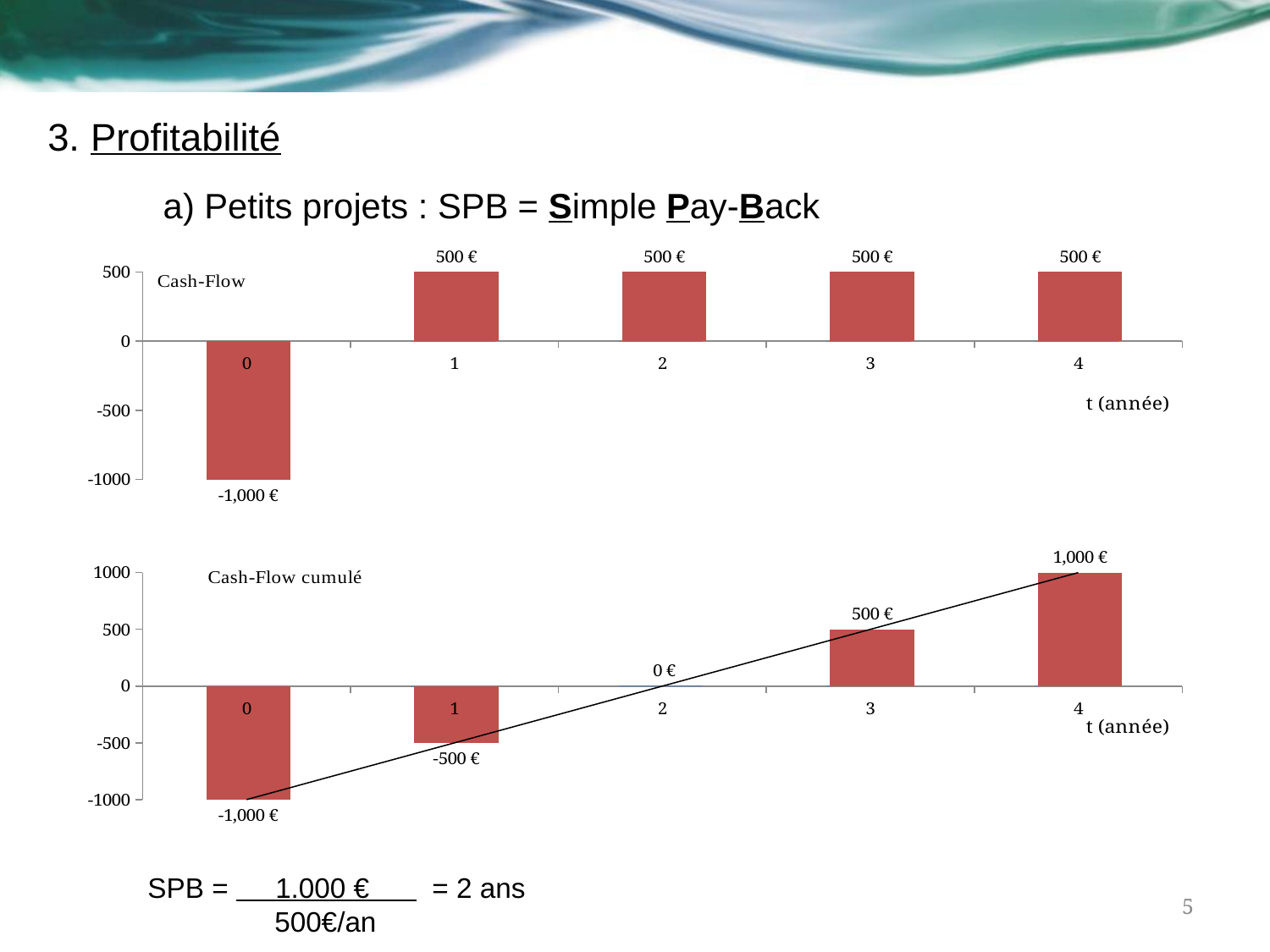
In the Cash-Flow cumulé chart, do the values rise or fall from year 0 to year 4? rise How many years (categories) are plotted in the Cash-Flow chart? 5 What kind of chart is the Cash-Flow cumulé chart? bar chart In the Cash-Flow cumulé chart, which year has the highest value? 4 In the Cash-Flow cumulé chart, is the value at year 3 larger or smaller than the value at year 1? larger In the Cash-Flow chart, what is the value at year 3? 500 € In the Cash-Flow cumulé chart, what is the value at year 1? -500 € In the Cash-Flow cumulé chart, what is the value at year 2? 0 € In the Cash-Flow chart, which year has the lowest value? 0 In the Cash-Flow cumulé chart, what is the difference between the values at year 4 and year 3? 500 € In the Cash-Flow chart, what is the value at year 0? -1,000 € In the Cash-Flow cumulé chart, what is the value at year 4? 1,000 €